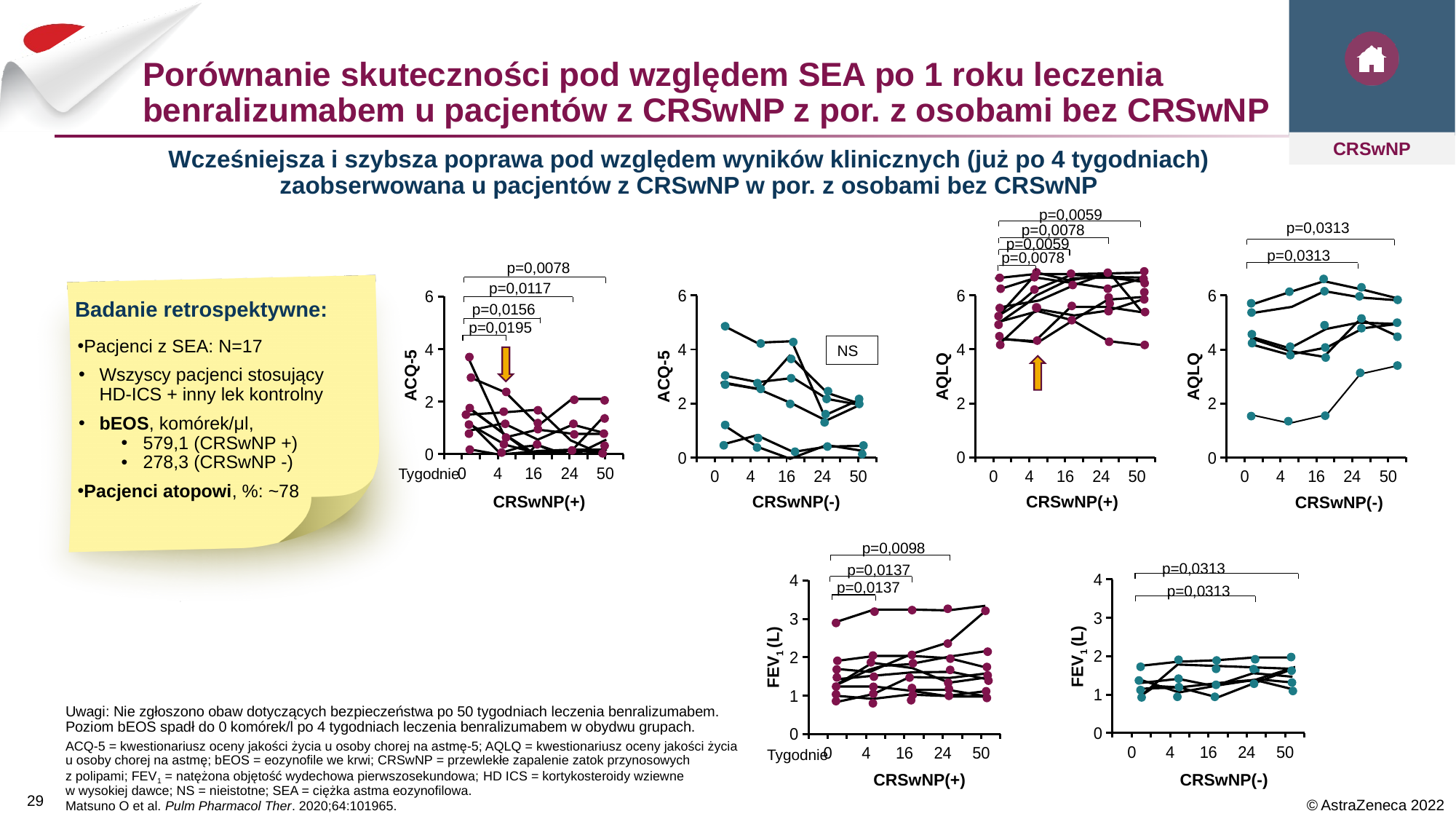
In the AQLQ CRSwNP(+) chart, do the patient values generally rise or fall from week 0 to week 50? rise What kind of chart is the ACQ-5 CRSwNP(+) chart? line chart What p-value is shown for the comparison between week 0 and week 4 in the ACQ-5 CRSwNP(+) chart? p=0,0195 What are the x-axis tick labels (weeks) on the AQLQ CRSwNP(-) chart? 0, 4, 16, 24, 50 What label is shown inside the ACQ-5 CRSwNP(-) chart instead of p-values? NS What p-value is shown for the comparison between week 0 and week 50 in the FEV1 (L) CRSwNP(+) chart? p=0,0098 In the AQLQ CRSwNP(-) chart, is the lowest patient value at week 0 greater or less than 2? less What is the maximum value shown on the y axis of the FEV1 (L) CRSwNP(-) chart? 4 How many time points are shown on the x axis of the FEV1 (L) CRSwNP(+) chart? 5 What p-value is shown for the comparison between week 0 and week 50 in the ACQ-5 CRSwNP(+) chart? p=0,0078 In the ACQ-5 CRSwNP(+) chart, do the patient values generally rise or fall from week 0 to week 50? fall In the ACQ-5 CRSwNP(+) chart, is the highest patient value at week 0 greater or less than 2? greater